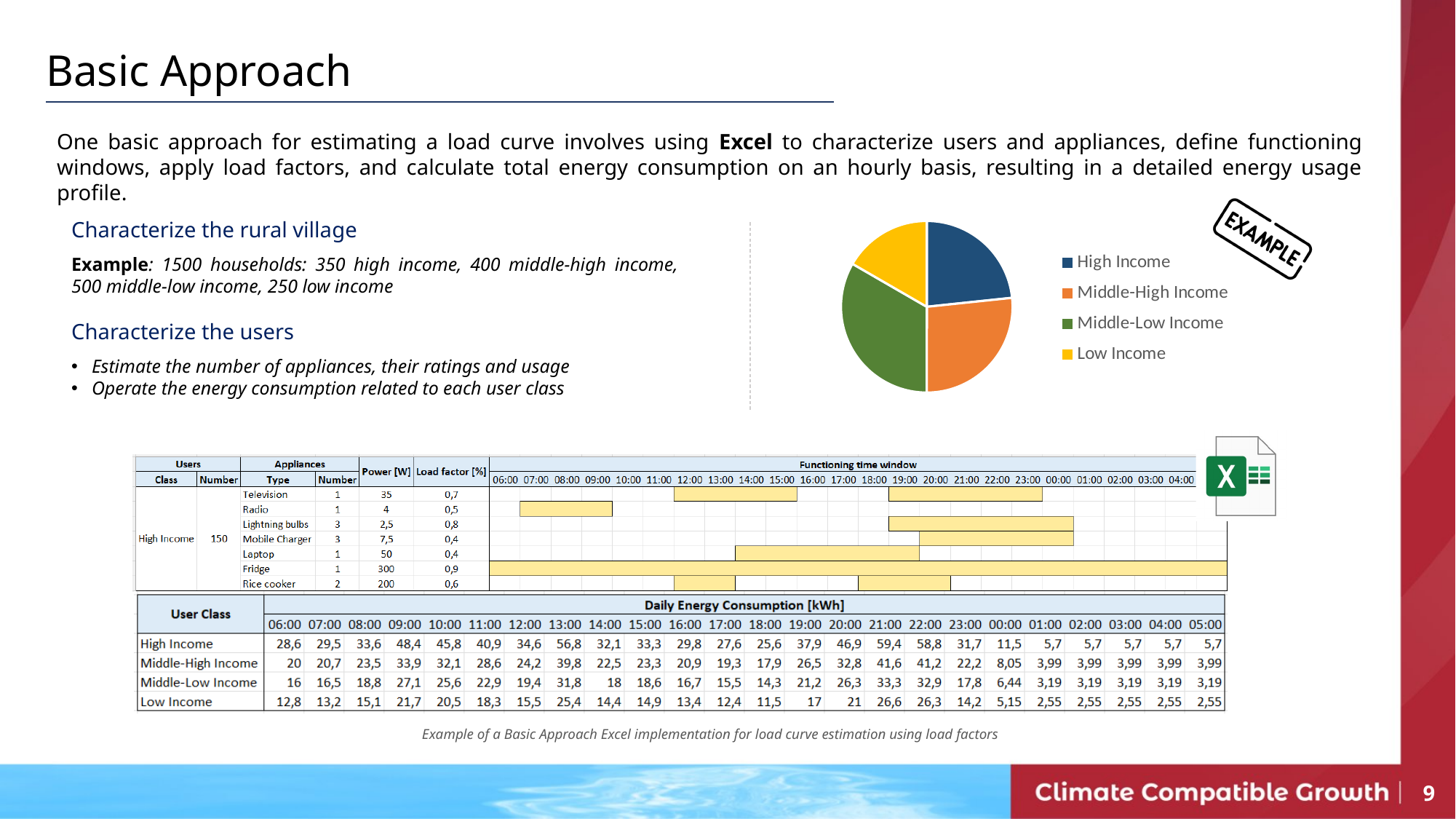
In the pie chart, which slice is larger: Middle-Low Income or High Income? Middle-Low Income Which user class has the smallest slice in the pie chart? Low Income In the pie chart, which slice is larger: Middle-Low Income or Low Income? Middle-Low Income How many slices does the pie chart have? 4 How many entries does the pie chart's legend list? 4 What kind of chart is shown in the upper right of the slide? Pie chart Which user class is shown in green in the pie chart? Middle-Low Income Which user class has the largest slice in the pie chart? Middle-Low Income What colour represents Low Income in the pie chart? Yellow